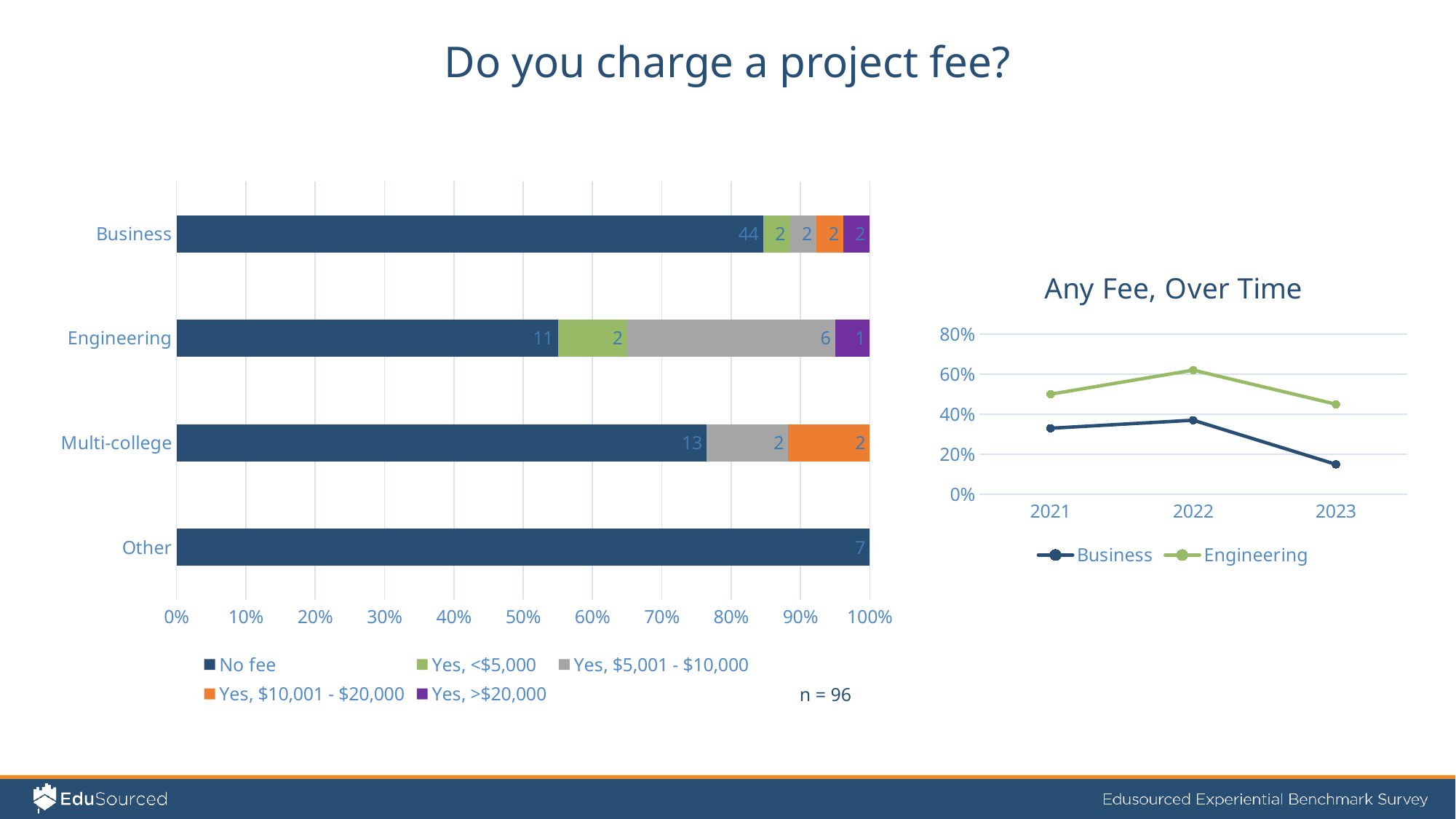
On the left stacked bar chart, how many categories are shown on the vertical axis? 4 On the left stacked bar chart, how many Engineering respondents reported 'Yes, $5,001 - $10,000'? 6 On the left stacked bar chart, how many series does the legend list? 5 On the left stacked bar chart, how many Business respondents reported 'No fee'? 44 In the 'Any Fee, Over Time' chart, is the Business value for 2023 greater or less than 20%? less On the left stacked bar chart, which category has the largest 'No fee' count? Business On the left stacked bar chart, what is the total number of respondents in the Business bar? 52 In the 'Any Fee, Over Time' chart, is the Engineering value for 2022 greater or less than 40%? greater On the left stacked bar chart, how many Multi-college respondents reported 'Yes, $10,001 - $20,000'? 2 On the left stacked bar chart, what is the total number of respondents in the Engineering bar? 20 What type of chart is 'Any Fee, Over Time'? line chart On the left stacked bar chart, what is the difference between the 'No fee' counts for Business and Multi-college? 31